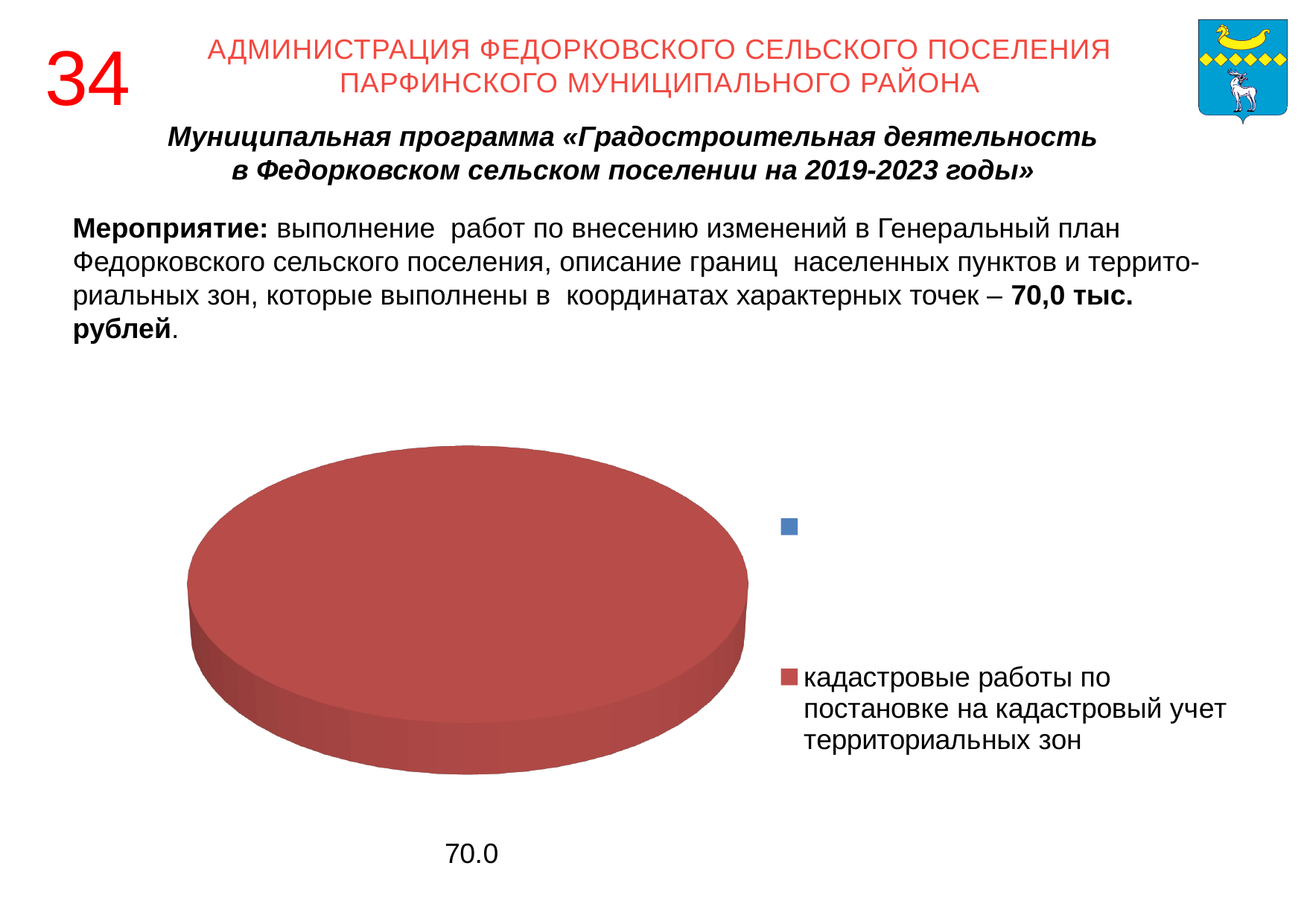
What kind of chart is shown on the slide? pie chart What is the value for "кадастровые работы по постановке на кадастровый учет территориальных зон" in the pie chart? 70.0 How many legend entries in the pie chart have a readable label? 1 How many slices are visible in the pie chart? 1 What value is printed as the data label on the pie chart? 70.0 What share of the pie does the slice "кадастровые работы по постановке на кадастровый учет территориальных зон" take up? 100% What colour is the slice for "кадастровые работы по постановке на кадастровый учет территориальных зон"? red